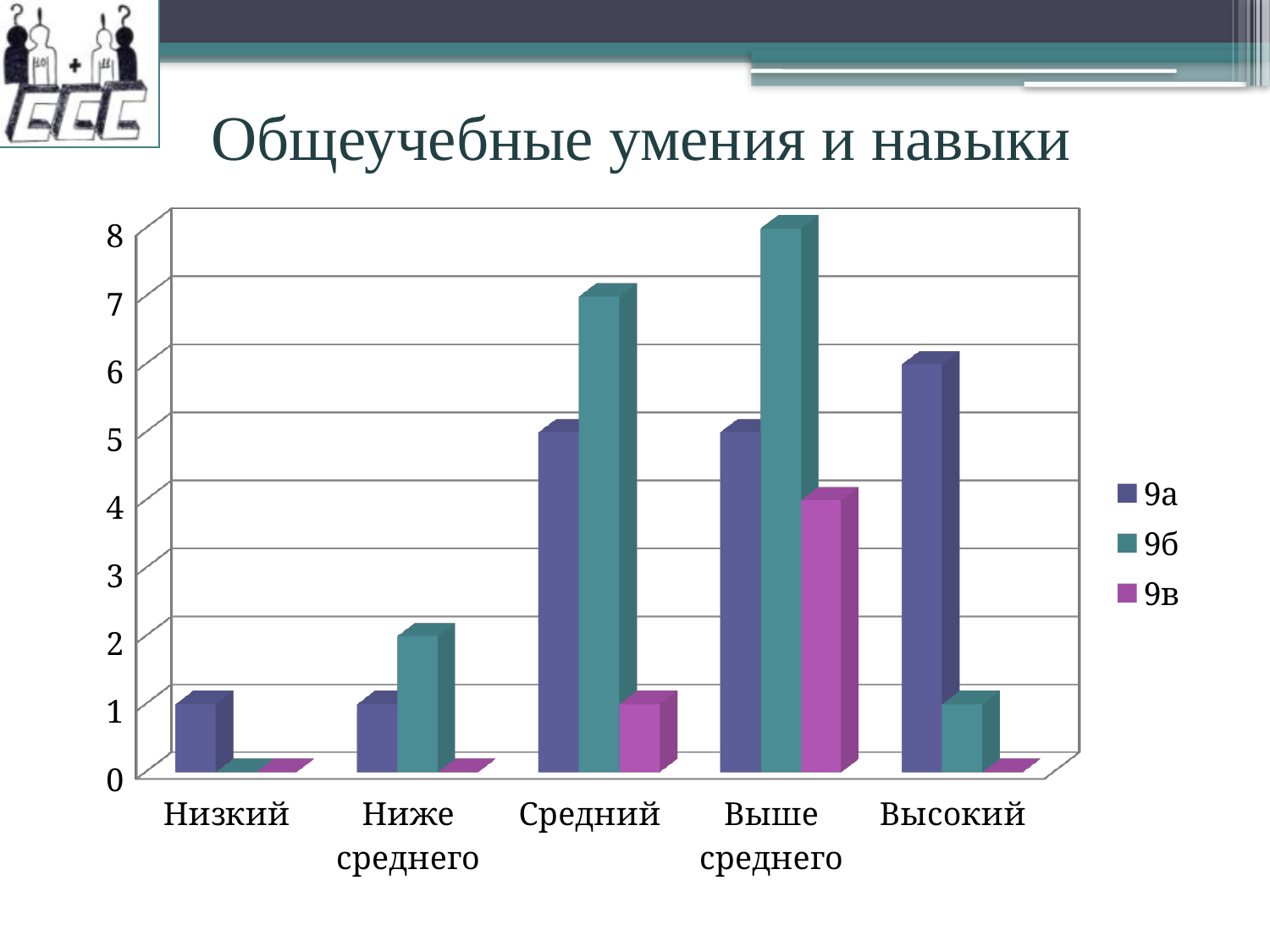
In which category is the 9а bar the highest? Высокий Is the value for 9а in the Низкий category greater or less than 3? less In which category is the 9б bar the highest? Выше среднего In the Средний category, which is larger: the 9а bar or the 9б bar? 9б Which series has the lowest bar in the Выше среднего category? 9в Is the value for 9б in the Средний category greater or less than 5? greater How many categories are shown on the x axis? 5 How many series does the legend list? 3 What is the title of the chart? Общеучебные умения и навыки In the Высокий category, which is larger: the 9а bar or the 9б bar? 9а What kind of chart is shown on the slide? bar chart Which series are listed in the legend? 9а, 9б, 9в